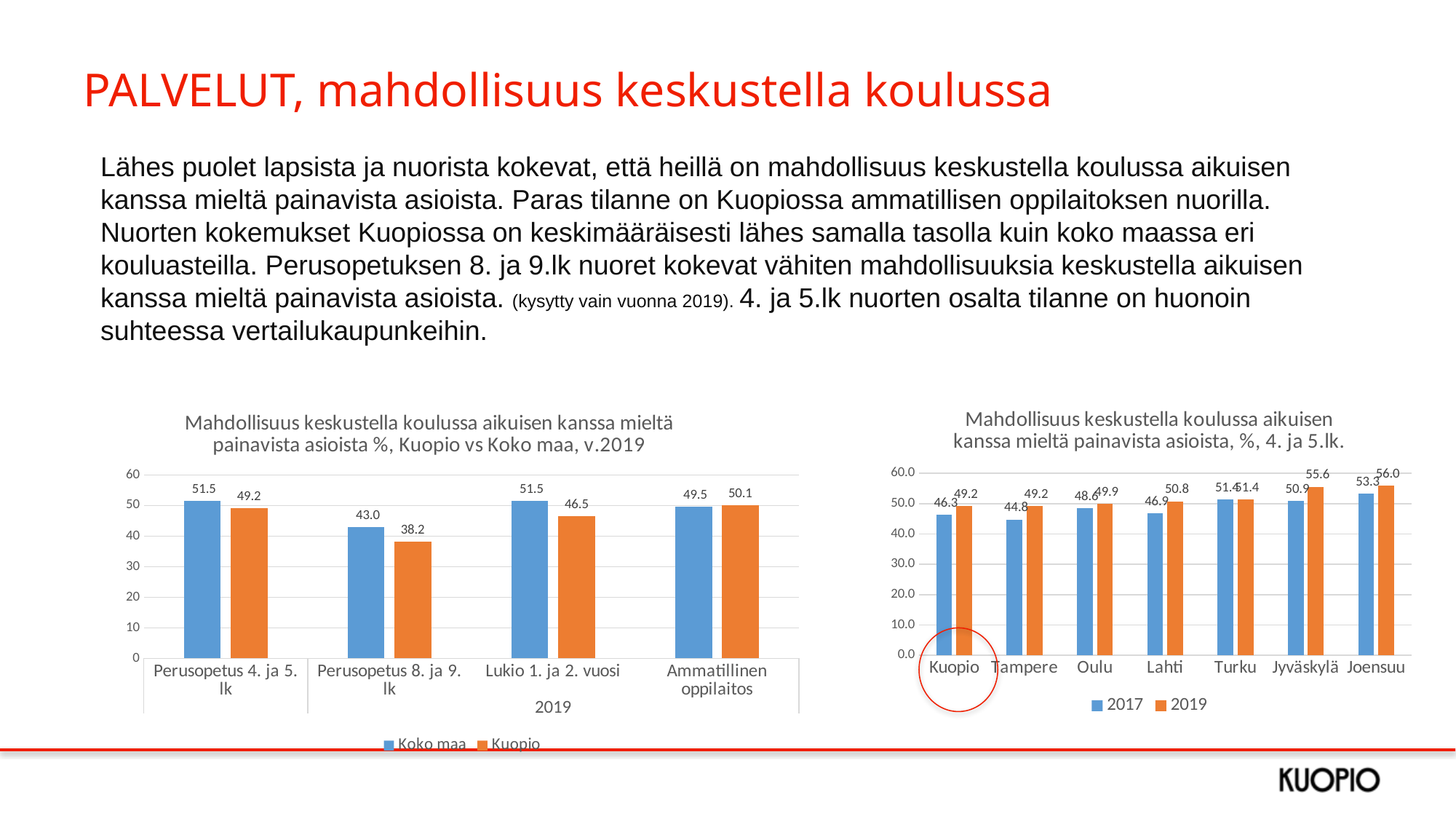
In the left chart (Kuopio vs Koko maa, v.2019), what is the difference between the Koko maa and Kuopio values for Perusopetus 8. ja 9. lk? 4.8 In the right chart (4. ja 5.lk.), which city has the highest 2019 value? Joensuu In the left chart (Kuopio vs Koko maa, v.2019), what is the Kuopio value for Perusopetus 8. ja 9. lk? 38.2 In the left chart (Kuopio vs Koko maa, v.2019), which category has the lowest Kuopio value? Perusopetus 8. ja 9. lk In the left chart (Kuopio vs Koko maa, v.2019), how many categories are shown on the x axis? 4 In the right chart (4. ja 5.lk.), how many series does the legend list? 2 In the right chart (4. ja 5.lk.), what is the 2017 value for Tampere? 44.8 In the left chart (Kuopio vs Koko maa, v.2019), which is larger for Ammatillinen oppilaitos: Koko maa or Kuopio? Kuopio What type of chart is the right chart (4. ja 5.lk.)? Bar chart In the right chart (4. ja 5.lk.), what is the difference between the 2019 and 2017 values for Kuopio? 2.9 In the left chart (Kuopio vs Koko maa, v.2019), what is the Koko maa value for Lukio 1. ja 2. vuosi? 51.5 In the right chart (4. ja 5.lk.), what is the 2019 value for Jyväskylä? 55.6